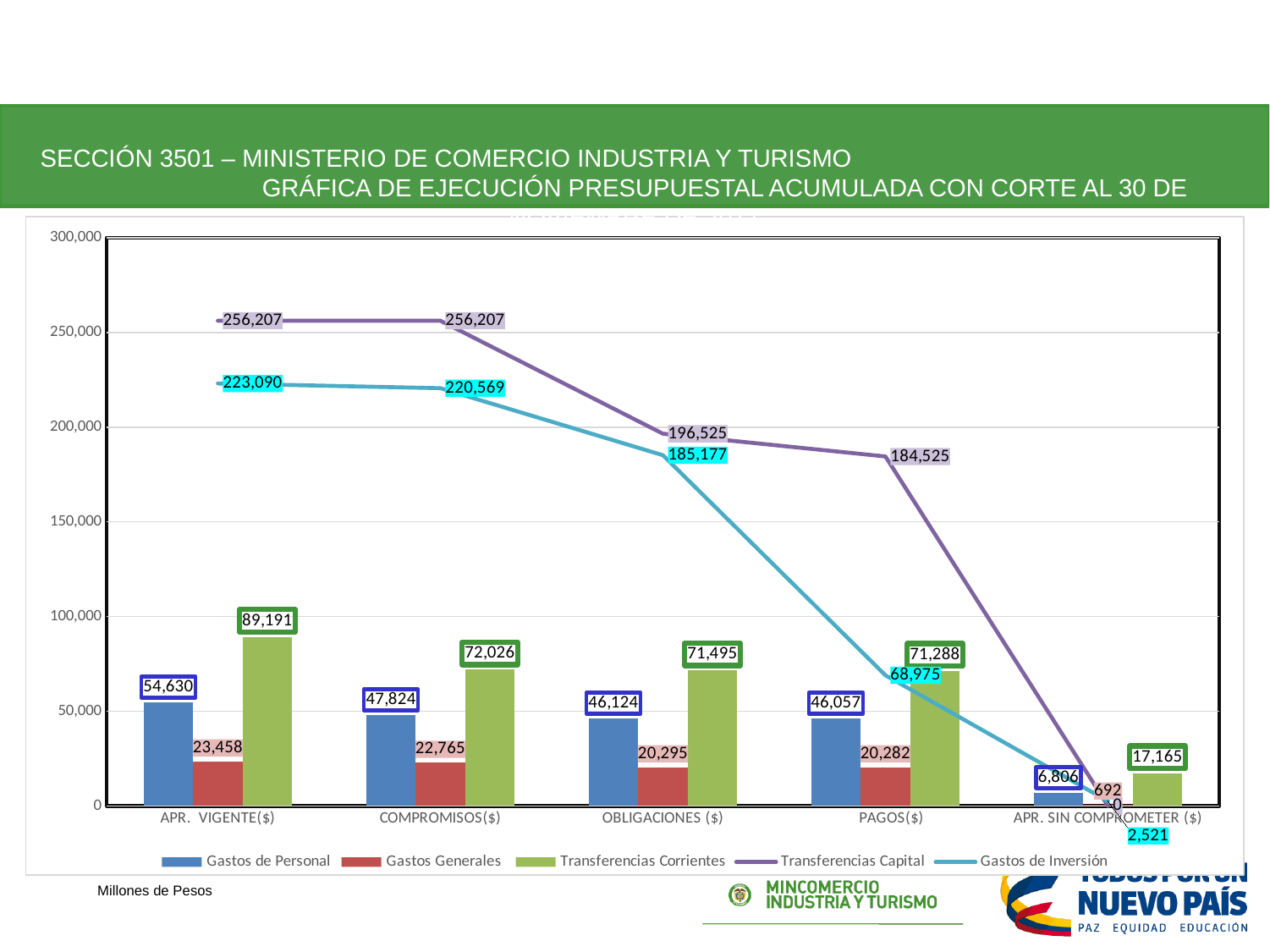
Does the Gastos de Inversión line rise or fall from APR. VIGENTE($) to APR. SIN COMPROMETER ($)? Fall What is the value of Gastos de Inversión for PAGOS($)? 68,975 How many categories are shown on the x axis? 5 What is the value of Transferencias Corrientes for APR. VIGENTE($)? 89,191 What is the value of Gastos Generales for APR. SIN COMPROMETER ($)? 692 How many series does the legend list? 5 Which category has the lowest value for Transferencias Corrientes? APR. SIN COMPROMETER ($) Which category has the highest value for Gastos de Personal? APR. VIGENTE($) What is the value of Gastos de Personal for COMPROMISOS($)? 47,824 What is the difference between Transferencias Capital and Gastos de Inversión for APR. VIGENTE($)? 33,117 Which is larger for COMPROMISOS($): Transferencias Capital or Gastos de Inversión? Transferencias Capital What is the value of Transferencias Capital for OBLIGACIONES ($)? 196,525